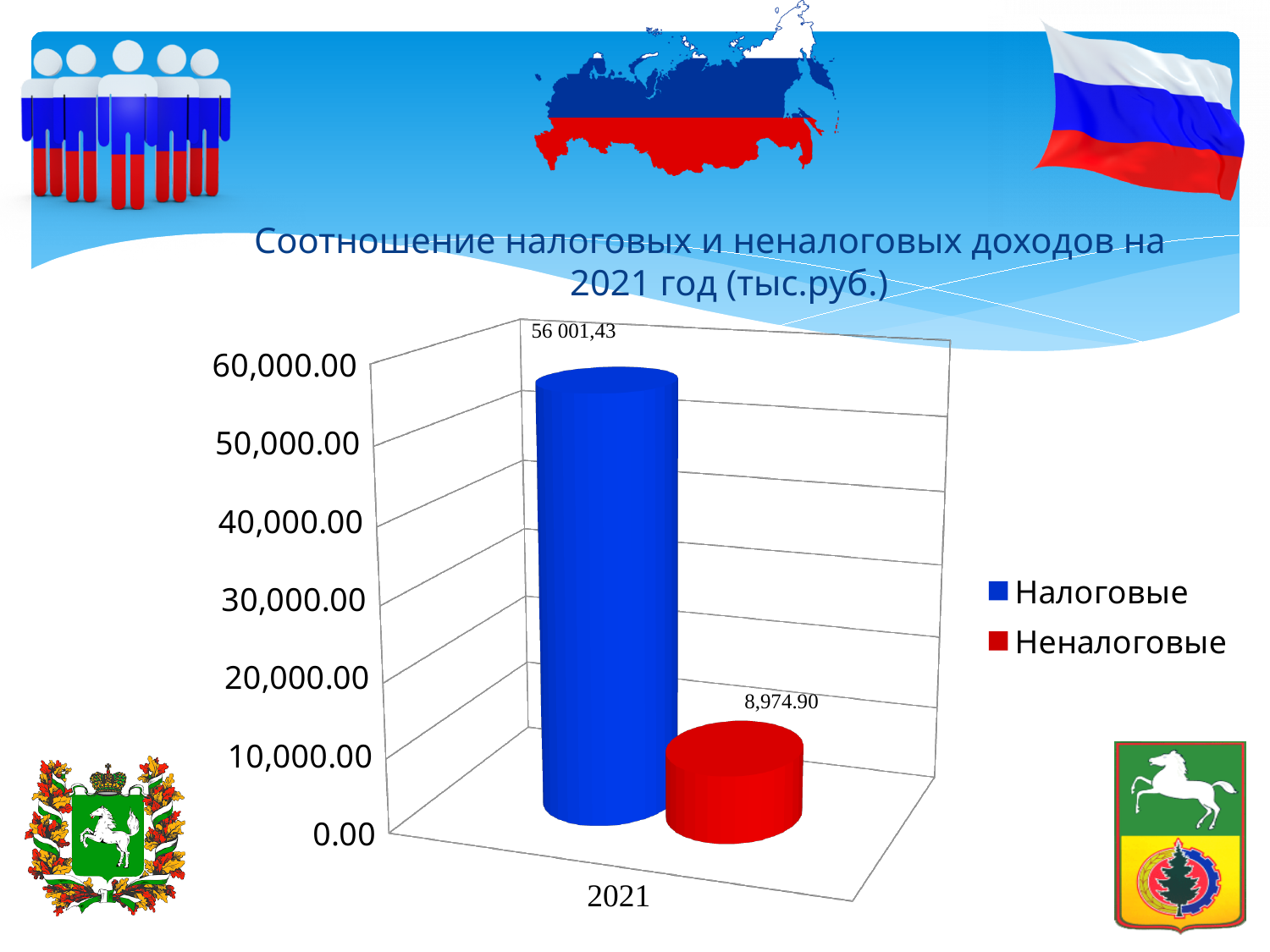
What is the value for Налоговые in 2021? 56 001,43 What colour is the bar for Неналоговые? red How many series does the legend list? 2 What year is shown on the x axis of the chart? 2021 Which series has the higher value in 2021, Налоговые or Неналоговые? Налоговые Which series has the lowest value on the chart? Неналоговые Which series has the highest value on the chart? Налоговые What is the value for Неналоговые in 2021? 8,974.90 Is the value for Налоговые greater or less than 50,000.00? greater How many categories are shown on the x axis? 1 Is the value for Неналоговые greater or less than 10,000.00? less What kind of chart is shown on the slide? bar chart